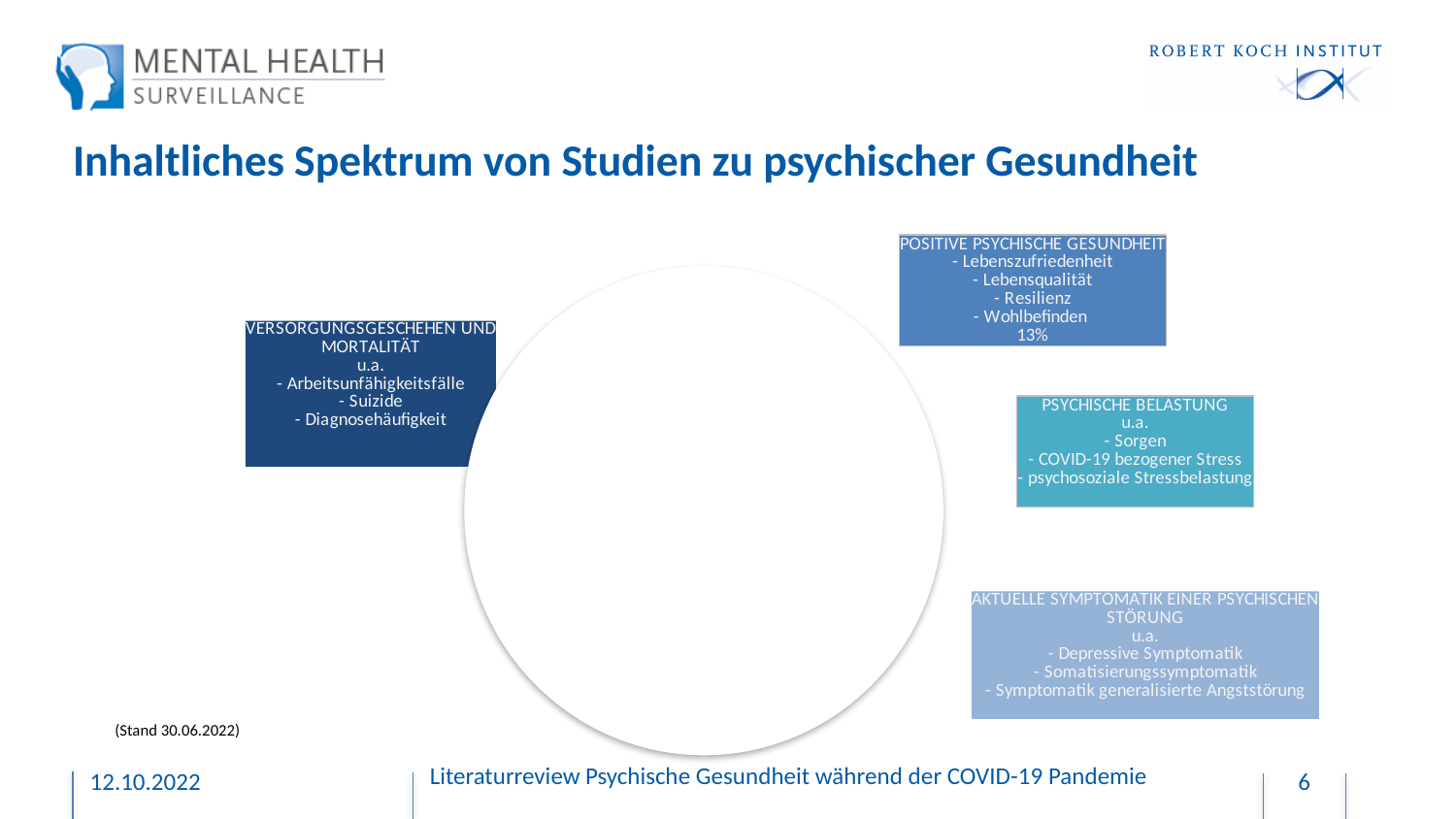
Which category's label lists Suizide and Diagnosehäufigkeit? VERSORGUNGSGESCHEHEN UND MORTALITÄT What share is printed for the category POSITIVE PSYCHISCHE GESUNDHEIT? 13% What kind of chart is shown on the slide? pie chart Which category's label lists Lebenszufriedenheit, Lebensqualität, Resilienz and Wohlbefinden? POSITIVE PSYCHISCHE GESUNDHEIT Is the share printed for POSITIVE PSYCHISCHE GESUNDHEIT greater or less than 20%? less How many categories are labelled around the chart? 4